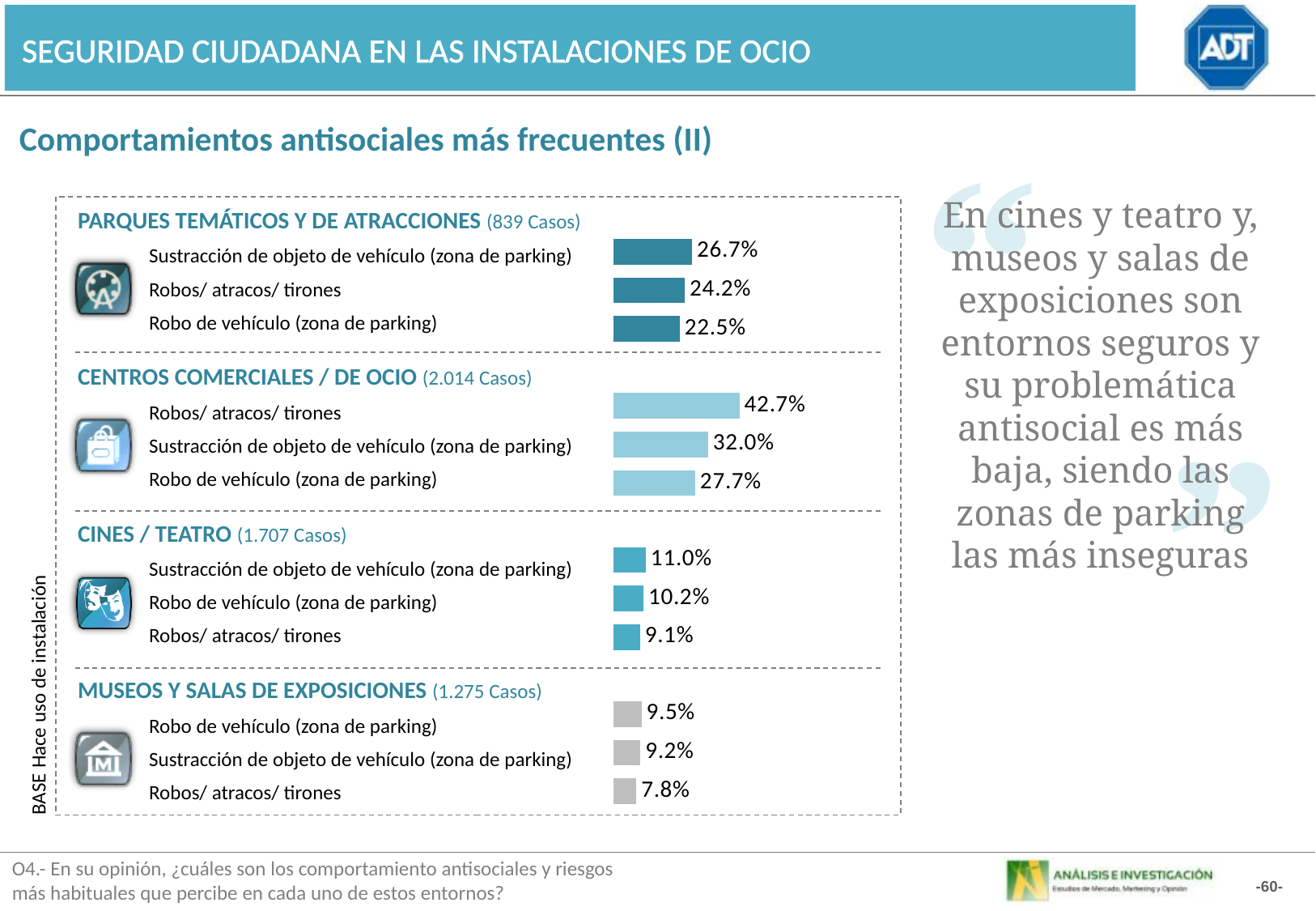
In the CINES / TEATRO chart, which category has the lowest value? Robos/ atracos/ tirones How many cases (Casos) are indicated for the CENTROS COMERCIALES / DE OCIO chart? 2.014 Casos Which is larger: 'Robos/ atracos/ tirones' in the CENTROS COMERCIALES / DE OCIO chart or 'Sustracción de objeto de vehículo (zona de parking)' in the PARQUES TEMÁTICOS Y DE ATRACCIONES chart? Robos/ atracos/ tirones in CENTROS COMERCIALES / DE OCIO In the CINES / TEATRO chart, what is the value for 'Robo de vehículo (zona de parking)'? 10.2% In the MUSEOS Y SALAS DE EXPOSICIONES chart, which category has the highest value? Robo de vehículo (zona de parking) In the MUSEOS Y SALAS DE EXPOSICIONES chart, what is the value for 'Robos/ atracos/ tirones'? 7.8% In the CENTROS COMERCIALES / DE OCIO chart, what is the value for 'Robos/ atracos/ tirones'? 42.7% How many categories are shown in the MUSEOS Y SALAS DE EXPOSICIONES chart? 3 In the PARQUES TEMÁTICOS Y DE ATRACCIONES chart, what is the value for 'Sustracción de objeto de vehículo (zona de parking)'? 26.7% What kind of chart is used in the CINES / TEATRO section? Bar chart In the PARQUES TEMÁTICOS Y DE ATRACCIONES chart, what is the difference between 'Robos/ atracos/ tirones' and 'Robo de vehículo (zona de parking)'? 1.7% In the CENTROS COMERCIALES / DE OCIO chart, what is the difference between 'Robos/ atracos/ tirones' and 'Robo de vehículo (zona de parking)'? 15.0%